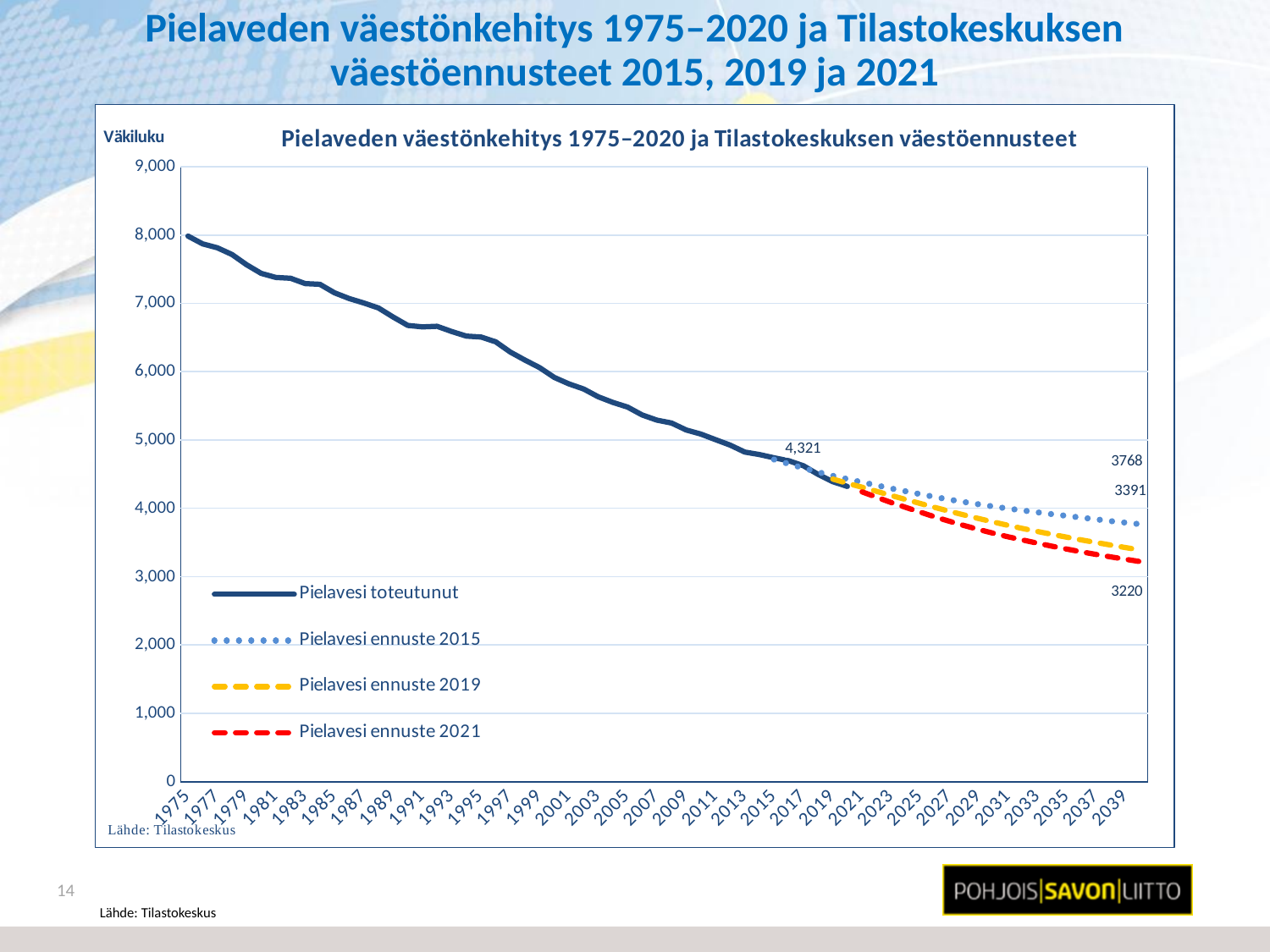
Which forecast series ends at a higher value, Pielavesi ennuste 2015 or Pielavesi ennuste 2021? Pielavesi ennuste 2015 What is the final value labelled at the end of the Pielavesi ennuste 2021 series? 3220 What kind of chart is shown on the slide? line chart What is the final value labelled at the end of the Pielavesi ennuste 2019 series? 3391 Is the value of the Pielavesi toteutunut series in 1975 greater or less than 7,000? greater What is the difference between the end values of the Pielavesi ennuste 2015 series (3768) and the Pielavesi ennuste 2019 series (3391)? 377 What label is shown on the vertical axis of the chart? Väkiluku Which of the three forecast series ends at the lowest value? Pielavesi ennuste 2021 How many series does the chart legend list? 4 What is the difference between the end values of the Pielavesi ennuste 2015 series (3768) and the Pielavesi ennuste 2021 series (3220)? 548 What is the final value labelled at the end of the Pielavesi ennuste 2015 series? 3768 Does the Pielavesi toteutunut series rise or fall from 1975 to 2020? fall